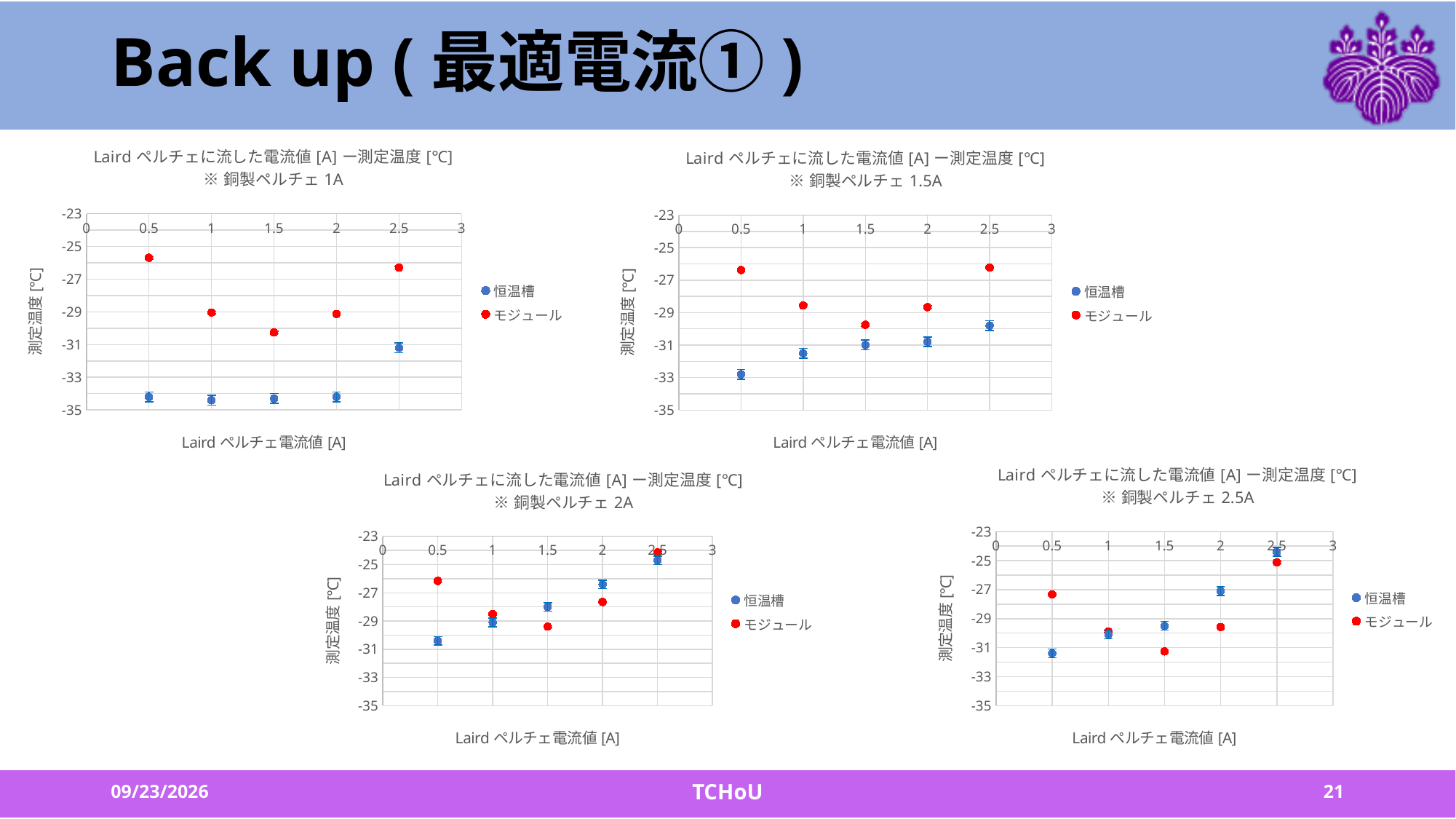
In the bottom-right chart (※ 銅製ペルチェ 2.5A), at which current value is the 恒温槽 temperature highest? 2.5 In the top-left chart (※ 銅製ペルチェ 1A), at which current value is the モジュール temperature lowest? 1.5 What kind of chart is the top-left chart (※ 銅製ペルチェ 1A)? scatter chart In the bottom-left chart (※ 銅製ペルチェ 2A), do the 恒温槽 values rise or fall as the current increases along the x axis? rise In the top-right chart (※ 銅製ペルチェ 1.5A), is the 恒温槽 value at 0.5 A greater or less than -31? less In the top-left chart (※ 銅製ペルチェ 1A), is the モジュール value at 1.5 A greater or less than -29? less In the bottom-right chart (※ 銅製ペルチェ 2.5A), is the モジュール value at 1.5 A greater or less than -29? less In the top-right chart (※ 銅製ペルチェ 1.5A), which series has the higher value at 0.5 A, 恒温槽 or モジュール? モジュール How many charts are shown on the slide? 4 In the top-left chart (※ 銅製ペルチェ 1A), how many data points does the モジュール series have? 5 How many series does the legend of the top-left chart (※ 銅製ペルチェ 1A) list? 2